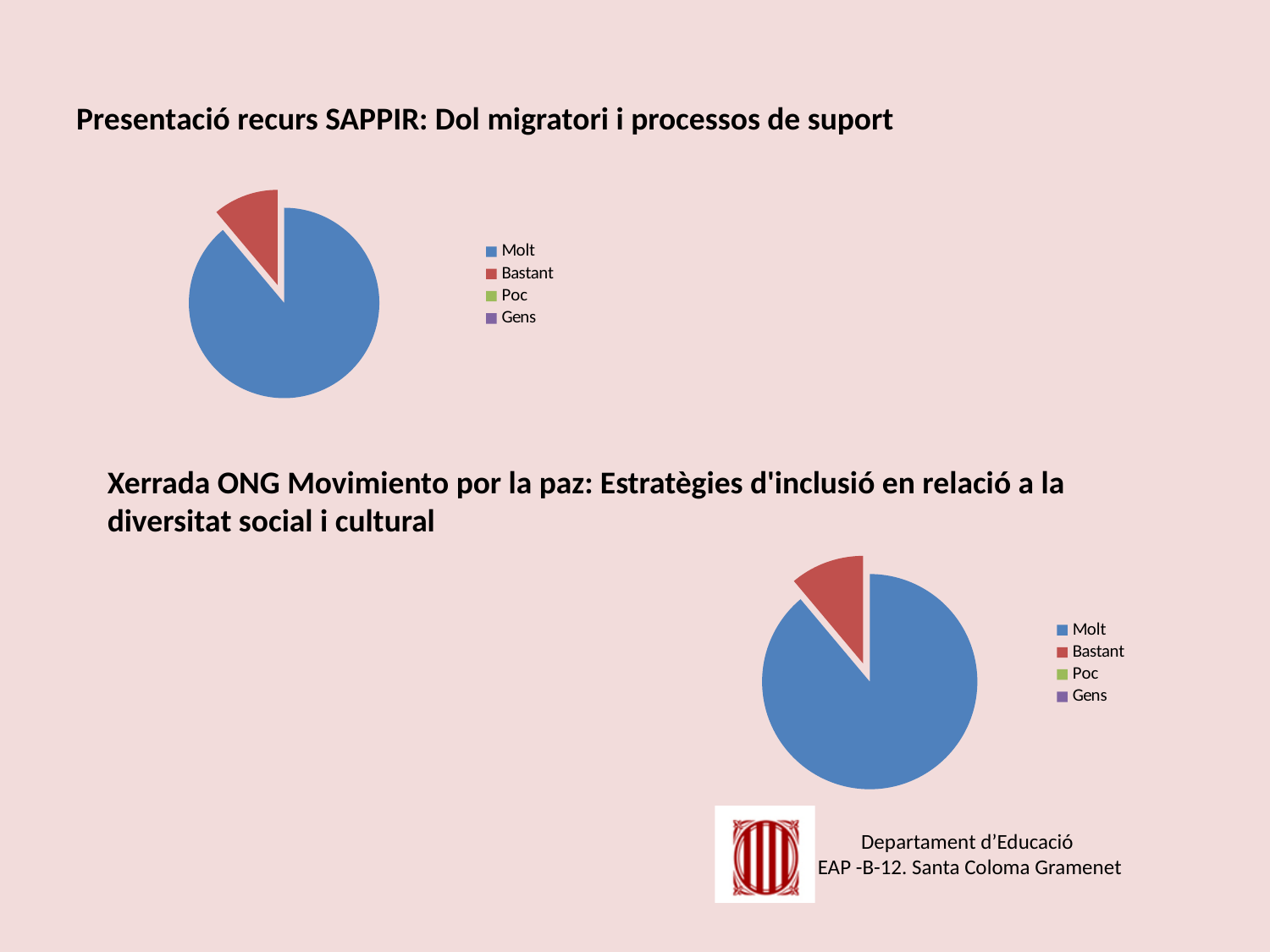
How many slices are visible in the bottom chart (Xerrada ONG Movimiento por la paz)? 2 In the top chart (Presentació recurs SAPPIR), what colour is the Bastant slice? red In the top chart (Presentació recurs SAPPIR), which is larger, the Molt slice or the Bastant slice? Molt How many entries does the legend of the bottom chart (Xerrada ONG Movimiento por la paz) list? 4 In the bottom chart (Xerrada ONG Movimiento por la paz), which category has the largest slice? Molt In the top chart (Presentació recurs SAPPIR), which category has the largest slice? Molt How many slices are visible in the top chart (Presentació recurs SAPPIR)? 2 What are the four legend entries of the bottom chart (Xerrada ONG Movimiento por la paz)? Molt, Bastant, Poc, Gens What kind of chart is shown under the title 'Presentació recurs SAPPIR: Dol migratori i processos de suport'? pie chart What kind of chart is shown under the title 'Xerrada ONG Movimiento por la paz'? pie chart In the bottom chart (Xerrada ONG Movimiento por la paz), which is larger, the Bastant slice or the Molt slice? Molt How many entries does the legend of the top chart (Presentació recurs SAPPIR) list? 4